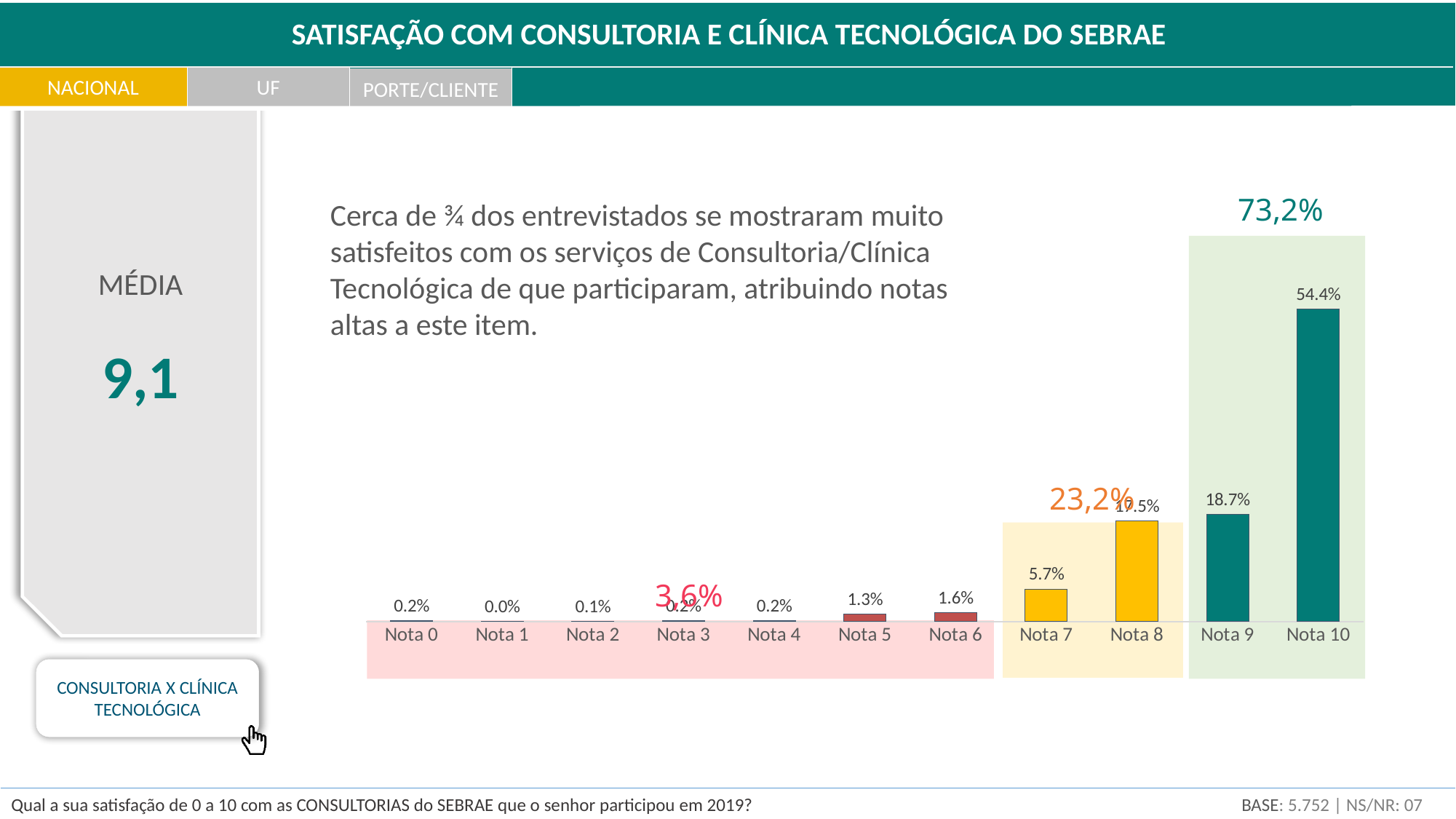
What combined percentage is shown above the green-shaded group covering Nota 9 and Nota 10? 73,2% Which category has the highest value in the chart? Nota 10 What percentage of respondents gave Nota 10? 54.4% Which is larger, the value for Nota 6 or the value for Nota 5? Nota 6 What is the difference between the values for Nota 10 and Nota 9? 35.7% What is the value shown for Nota 5? 1.3% What is the value shown for Nota 9? 18.7% What kind of chart is shown on the slide? Bar chart What is the value shown for Nota 7? 5.7% How many categories (notas) are shown on the x axis of the chart? 11 Which category has the lowest value in the chart? Nota 1 What is the difference between the values for Nota 6 and Nota 5? 0.3%